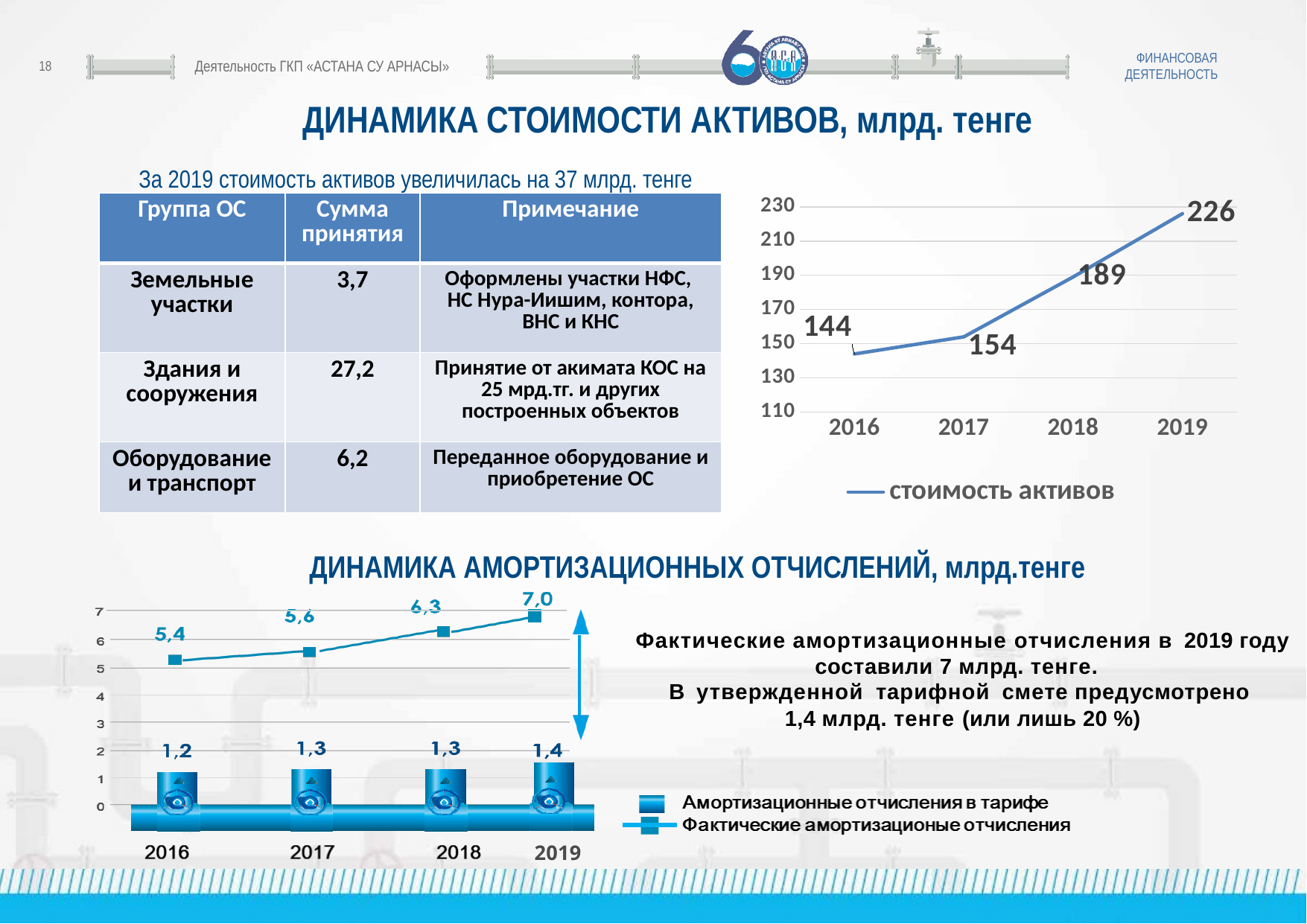
In the depreciation chart (bottom left), which is larger in 2016: the actual depreciation or the tariff depreciation? actual depreciation (5,4) In the depreciation chart (bottom left), what is the value of Амортизационные отчисления в тарифе for 2019? 1,4 In the asset value chart (top right), what is the difference between the 2019 and 2018 values? 37 How many series does the legend of the depreciation chart (bottom left) list? 2 In the asset value chart (top right), how many years are plotted? 4 In the asset value chart (top right), what is the value for 2016? 144 In the asset value chart (top right), which year has the lowest value? 2016 In the asset value chart (top right), what is the value for 2019? 226 In the asset value chart (top right), do the values rise or fall from 2016 to 2019? rise What type of chart is the asset value chart in the top right? line chart In the depreciation chart (bottom left), what is the value of Фактические амортизационые отчисления for 2018? 6,3 In the depreciation chart (bottom left), what is the difference between the actual depreciation and the tariff depreciation in 2019? 5,6